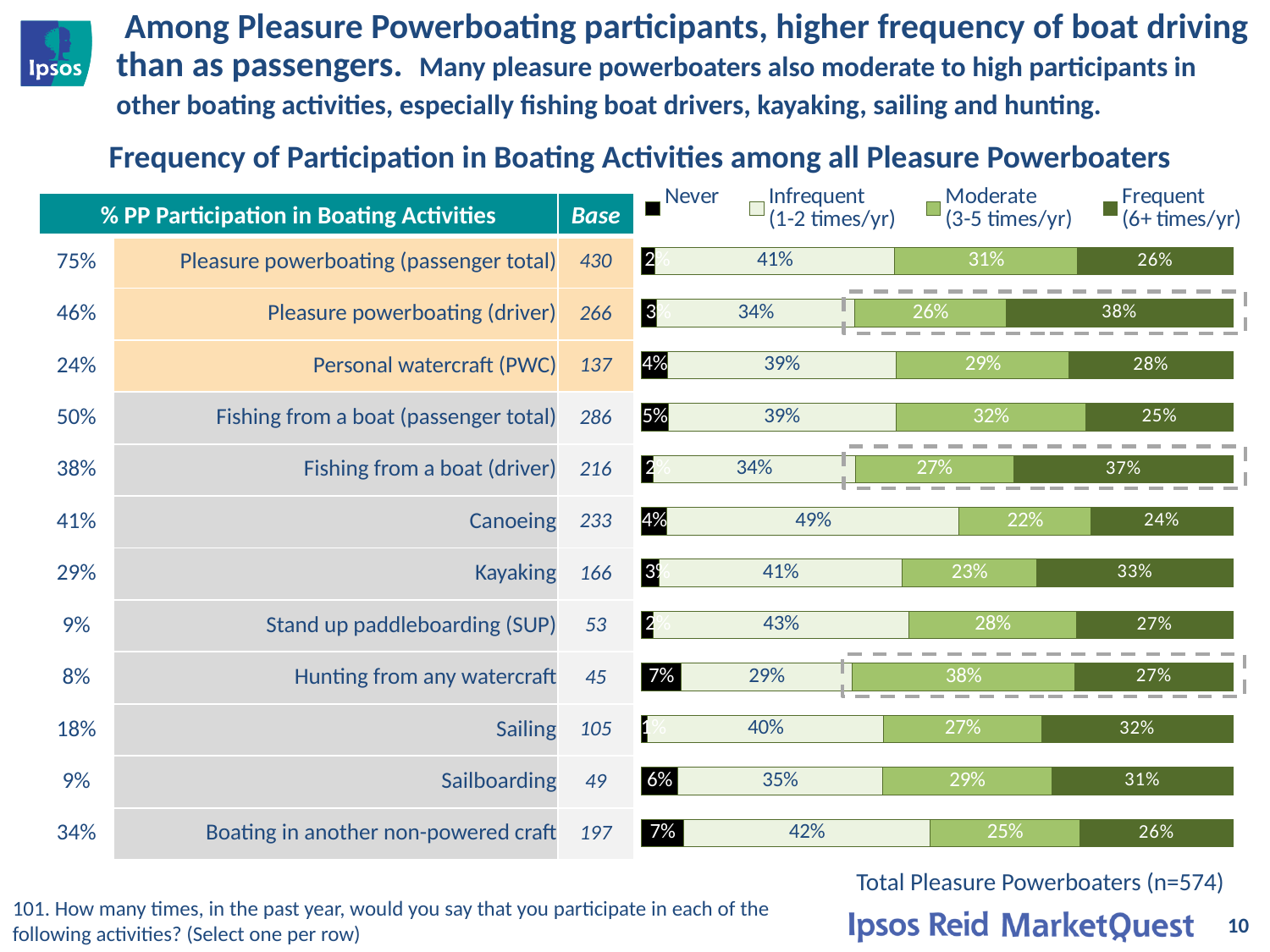
What percentage of pleasure powerboaters are Frequent (6+ times/yr) participants in Pleasure powerboating (driver)? 38% Which activity has the lowest Moderate (3-5 times/yr) value? Canoeing Which is larger: the Frequent (6+ times/yr) value for Kayaking or for Sailing? Kayaking What kind of chart is used to show frequency of participation? Stacked bar chart Which activity has the highest Infrequent (1-2 times/yr) value? Canoeing What is the Infrequent (1-2 times/yr) value for Canoeing? 49% What is the Moderate (3-5 times/yr) value for Hunting from any watercraft? 38% What is the Never value for Boating in another non-powered craft? 7% How many series does the legend list? 4 How many boating activities are shown in the chart? 12 What is the difference between the Frequent (6+ times/yr) values for Pleasure powerboating (driver) and Pleasure powerboating (passenger total)? 12 percentage points Which activity has the highest Frequent (6+ times/yr) value? Pleasure powerboating (driver)